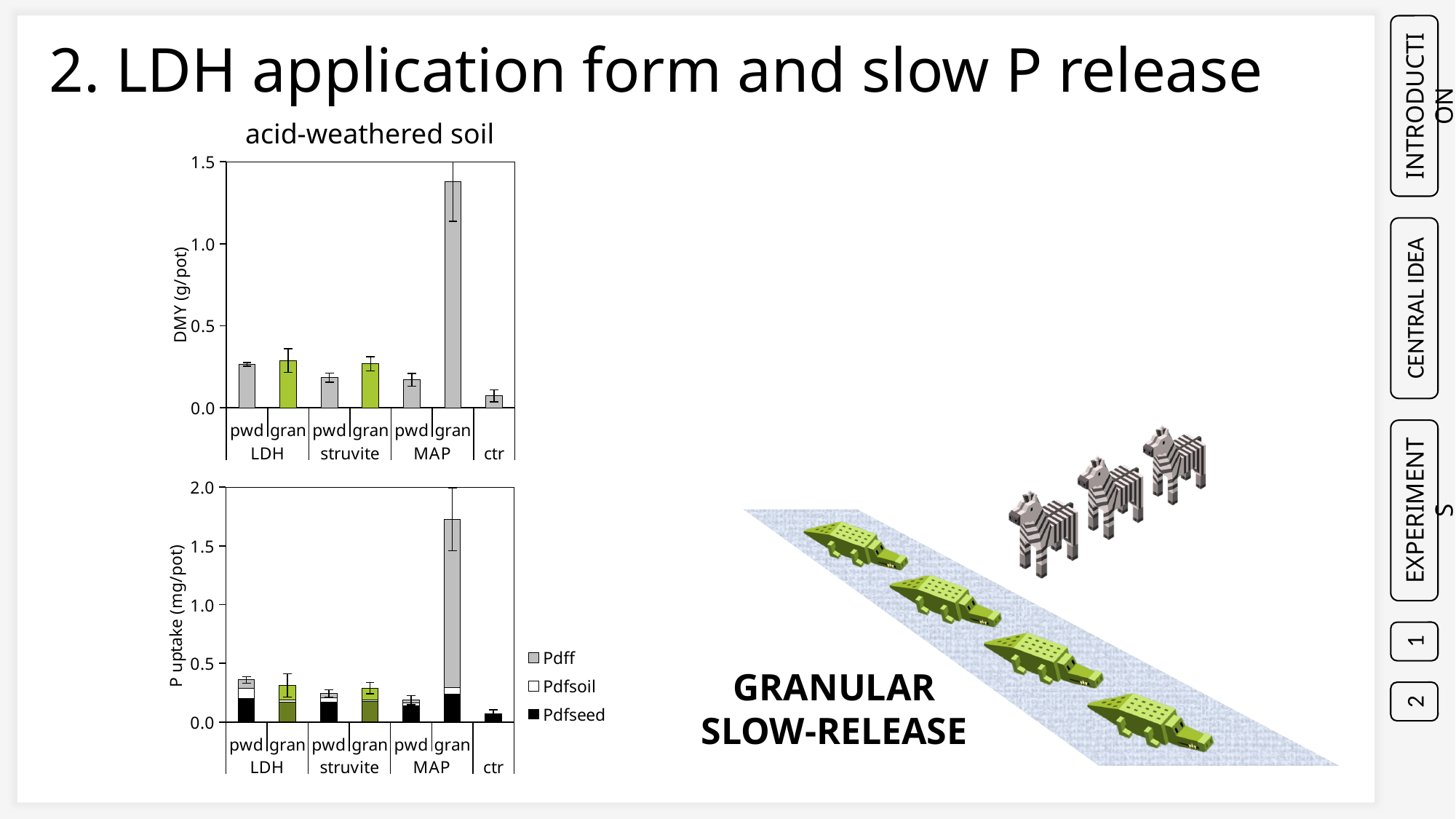
In the top chart (DMY), which is larger: MAP pwd or MAP gran? MAP gran In the top chart (DMY), is the value for LDH pwd greater or less than 0.5 g/pot? less What is the y-axis label of the bottom chart? P uptake (mg/pot) How many series does the legend of the bottom chart (P uptake) list? 3 How many bars are plotted in the top chart (DMY)? 7 What type of chart is the top chart titled 'acid-weathered soil'? bar chart In the top chart (DMY), which bar has the lowest value? ctr In the bottom chart (P uptake), is the total for ctr greater or less than 0.5 mg/pot? less In the bottom chart (P uptake), is the total for MAP gran greater or less than 1.5 mg/pot? greater In the top chart (DMY), which bar has the highest value? MAP gran In the bottom chart (P uptake), which bar has the highest total? MAP gran